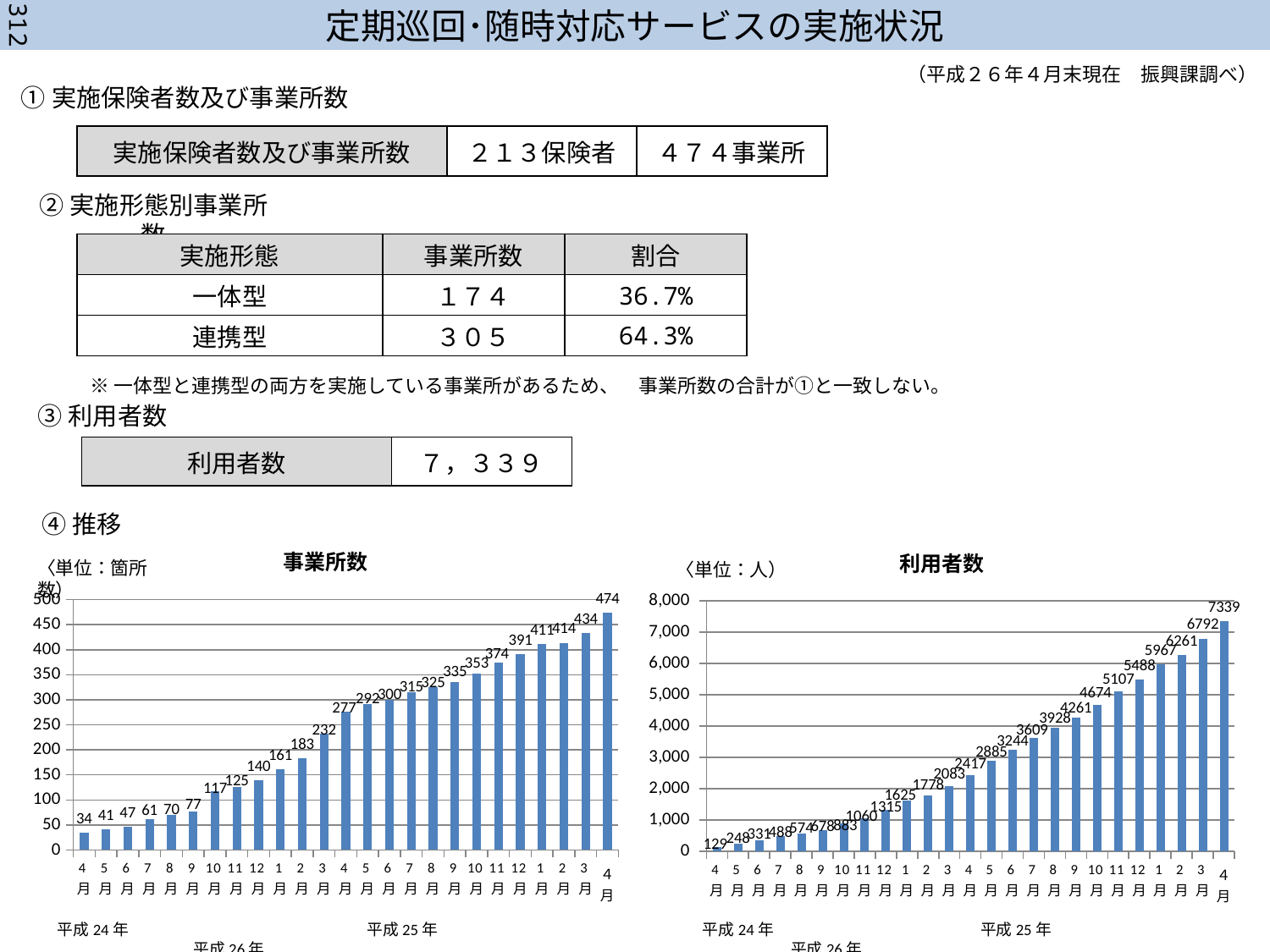
In the 利用者数 chart, what is the value for the last bar (4月 平成26年)? 7339 In the 利用者数 chart, what is the value for the first bar (4月 平成24年)? 129 In the 事業所数 chart, which month has the highest value? 4月 (平成26年) In the 事業所数 chart, what is the value for the first bar (4月 平成24年)? 34 What type of chart is the 利用者数 chart? bar chart In the 利用者数 chart, which month has the lowest value? 4月 (平成24年) In the 事業所数 chart, what is the value for the last bar (4月 平成26年)? 474 In the 事業所数 chart, what is the difference between the last bar (474) and the bar before it (434)? 40 How many bars are plotted in the 事業所数 chart? 25 In the 事業所数 chart, is the value for 1月 平成25年 (161) larger or smaller than the value for 12月 平成24年 (140)? larger In the 利用者数 chart, do the values rise or fall from left to right along the x axis? rise In the 利用者数 chart, what is the difference between the last bar (7339) and the bar before it (6792)? 547